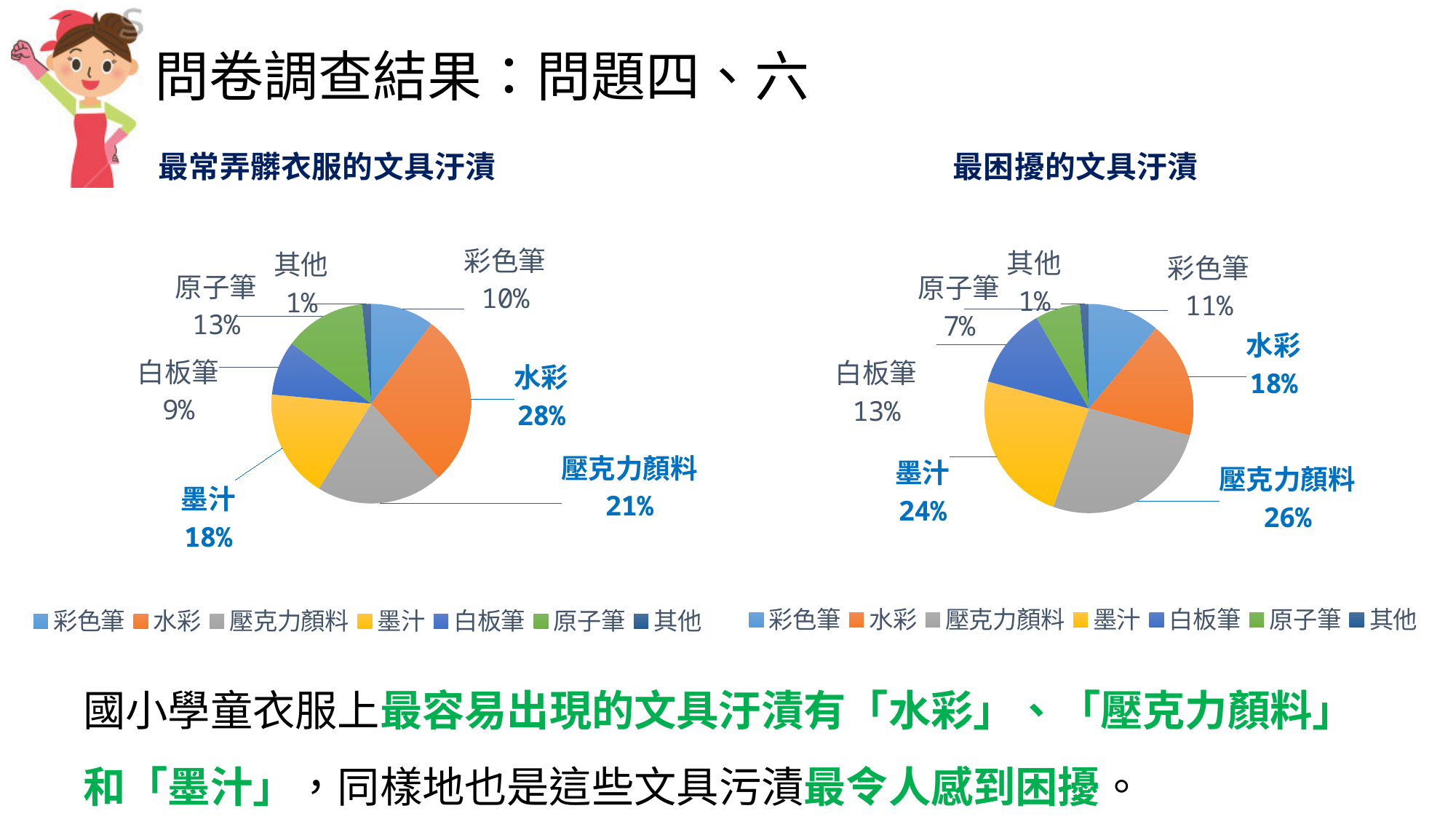
In the chart titled 最困擾的文具汙漬, what is the value for 墨汁? 24% In the chart titled 最困擾的文具汙漬, what is the difference between 壓克力顏料 and 水彩? 8% In the chart titled 最常弄髒衣服的文具汙漬, which category has the largest share? 水彩 In the chart titled 最常弄髒衣服的文具汙漬, what is the value for 水彩? 28% How many categories does the chart titled 最常弄髒衣服的文具汙漬 show? 7 In the chart titled 最常弄髒衣服的文具汙漬, which category has the smallest share? 其他 In the chart titled 最常弄髒衣服的文具汙漬, which is larger, 原子筆 or 白板筆? 原子筆 In the chart titled 最常弄髒衣服的文具汙漬, what is the difference between 水彩 and 墨汁? 10% In the chart titled 最困擾的文具汙漬, which category has the largest share? 壓克力顏料 What kind of chart is the chart titled 最困擾的文具汙漬? pie chart In the chart titled 最困擾的文具汙漬, what is the value for 原子筆? 7% In the chart titled 最困擾的文具汙漬, which is larger, 白板筆 or 原子筆? 白板筆